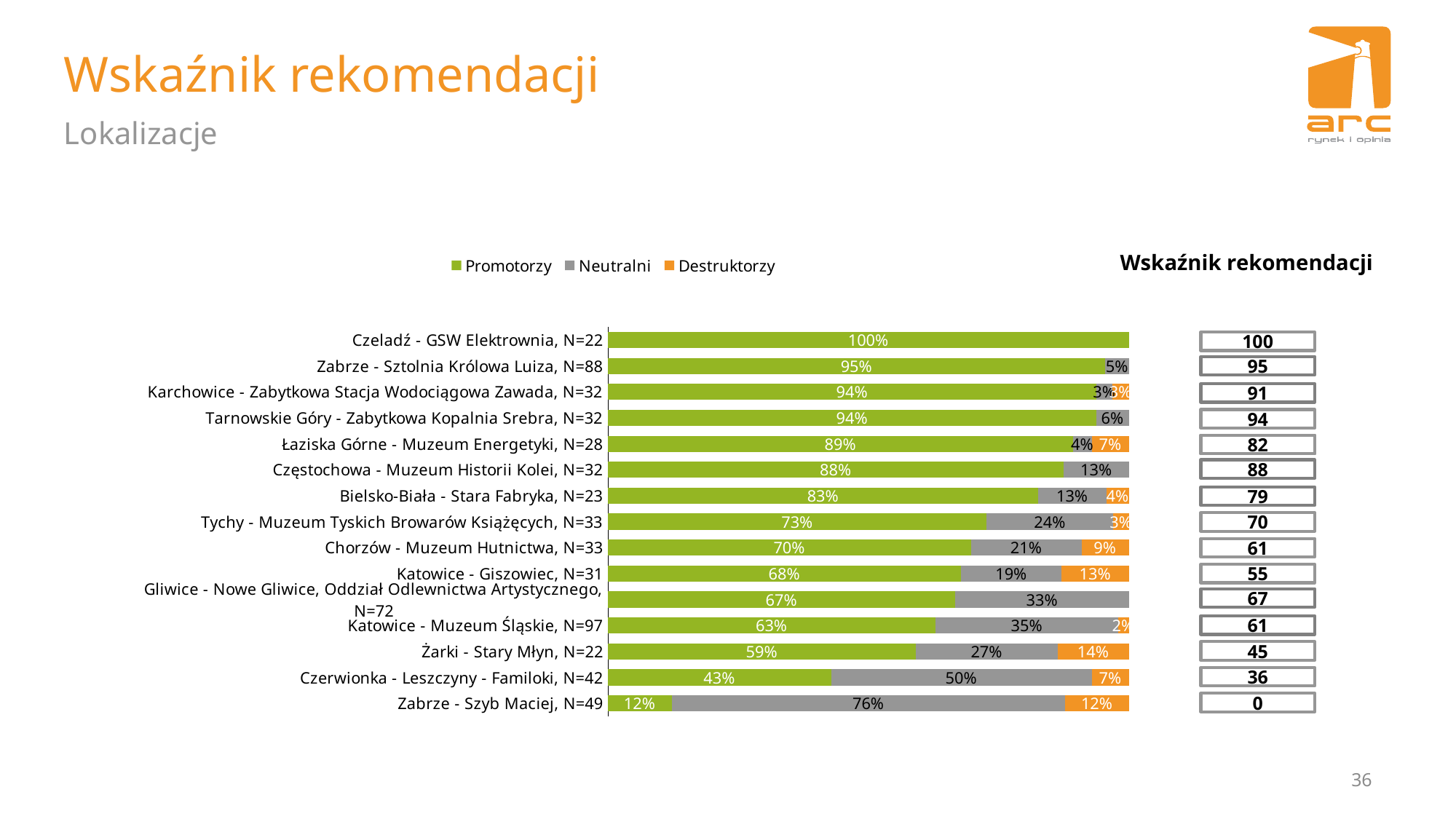
Which location has the lowest Promotorzy value? Zabrze - Szyb Maciej, N=49 How many series does the legend list? 3 Which location has the highest Neutralni value? Zabrze - Szyb Maciej, N=49 What is the Destruktorzy value for Żarki - Stary Młyn, N=22? 14% Which is larger: the Destruktorzy value for Katowice - Giszowiec, N=31 or for Chorzów - Muzeum Hutnictwa, N=33? Katowice - Giszowiec, N=31 Which series is shown in orange in the legend? Destruktorzy What is the difference between the Promotorzy values for Tychy - Muzeum Tyskich Browarów Książęcych, N=33 and Chorzów - Muzeum Hutnictwa, N=33? 3% What is the Neutralni value for Zabrze - Szyb Maciej, N=49? 76% How many locations (categories) are shown in the chart? 15 What kind of chart is shown on the slide? stacked bar chart What is the Promotorzy value for Czeladź - GSW Elektrownia, N=22? 100% What is the Neutralni value for Czerwionka - Leszczyny - Familoki, N=42? 50%